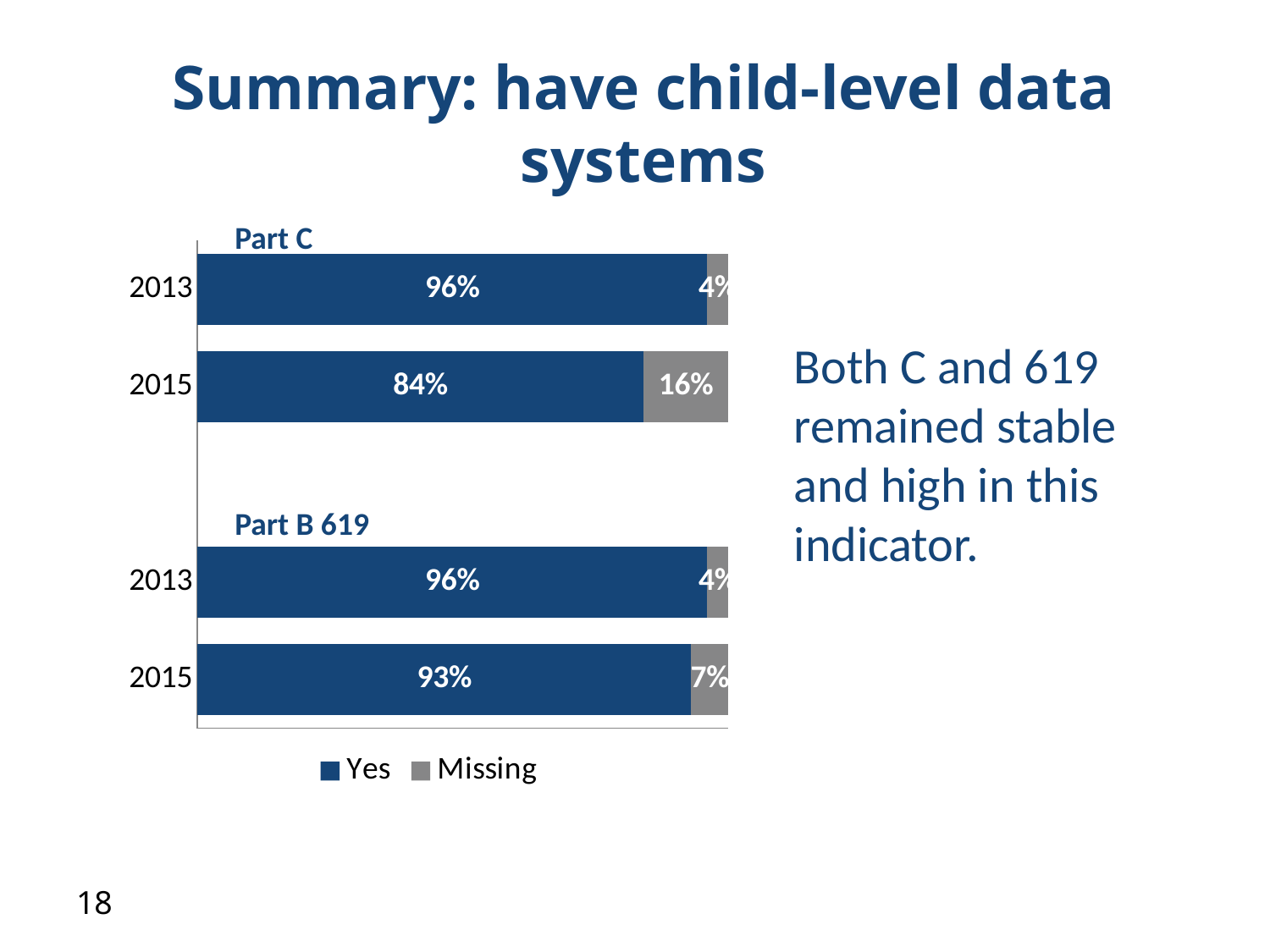
What kind of chart is shown on the slide? Stacked bar chart What is the total of the Part C 2015 stacked bar? 100% Which bar has the lowest 'Yes' value? Part C 2015 Did the 'Yes' value for Part C rise or fall from 2013 to 2015? Fall What is the difference between the 'Yes' values for Part C in 2013 and 2015? 12% What is the 'Yes' value for Part C in 2013? 96% Which is larger, the 'Yes' value for Part C in 2015 or for Part B 619 in 2015? Part B 619 in 2015 What is the 'Missing' value for Part B 619 in 2015? 7% What is the 'Yes' value for Part C in 2015? 84% How many series does the legend list? 2 What is the 'Yes' value for Part B 619 in 2015? 93% What is the 'Missing' value for Part C in 2015? 16%